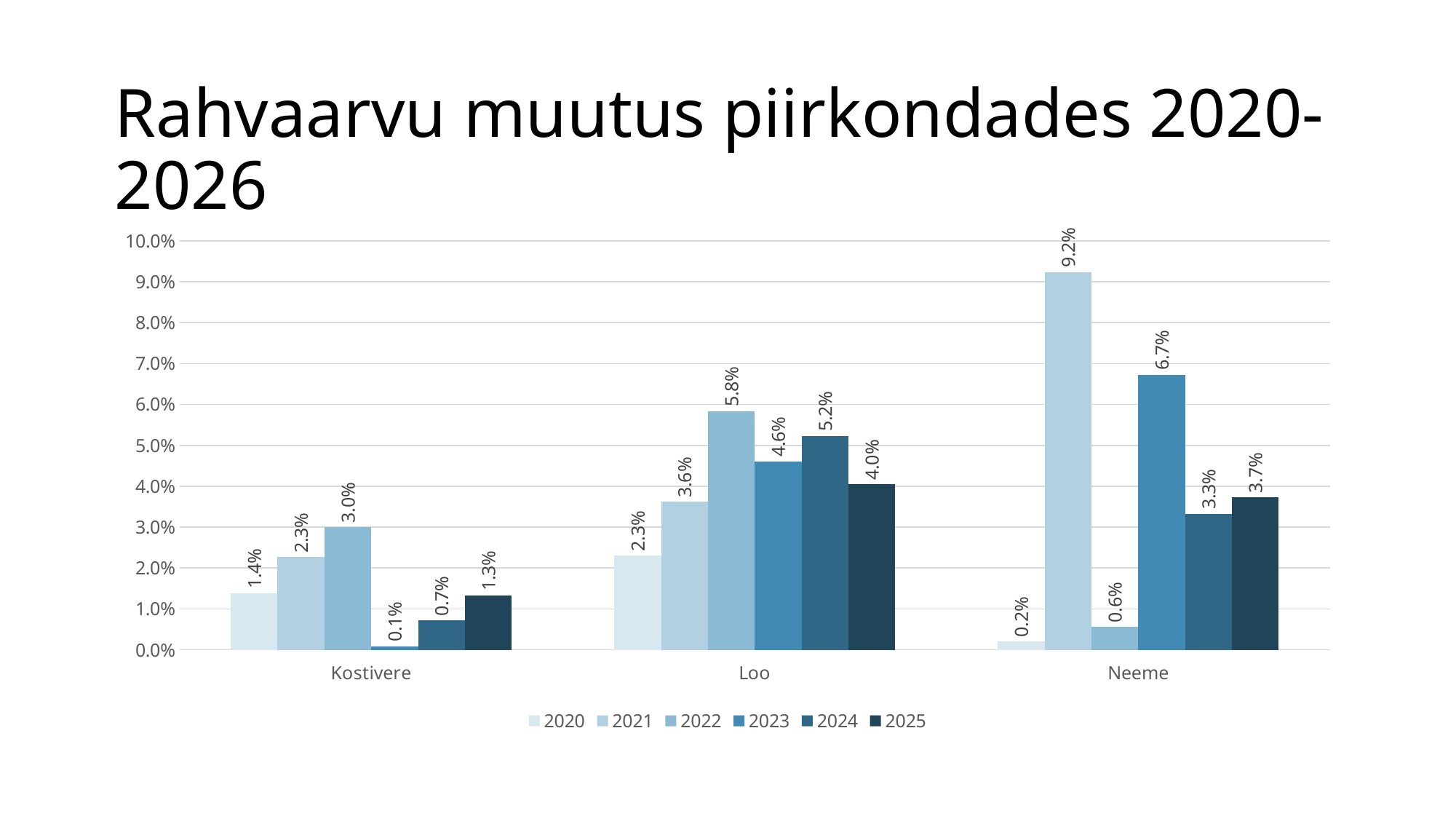
Which region has the highest value in 2023? Neeme Is the value for Neeme in 2021 greater or less than 9.0%? greater How many series does the legend list? 6 Which region has the lowest value in 2020? Neeme What is the value for Loo in 2022? 5.8% What is the difference between the 2021 and 2020 values for Neeme? 9.0% What is the value for Neeme in 2021? 9.2% What is the value for Kostivere in 2023? 0.1% Which is larger for Loo: the 2024 value or the 2025 value? 2024 How many regions are shown on the x axis? 3 What kind of chart is shown on the slide? Bar chart What is the title of the chart on the slide? Rahvaarvu muutus piirkondades 2020-2026